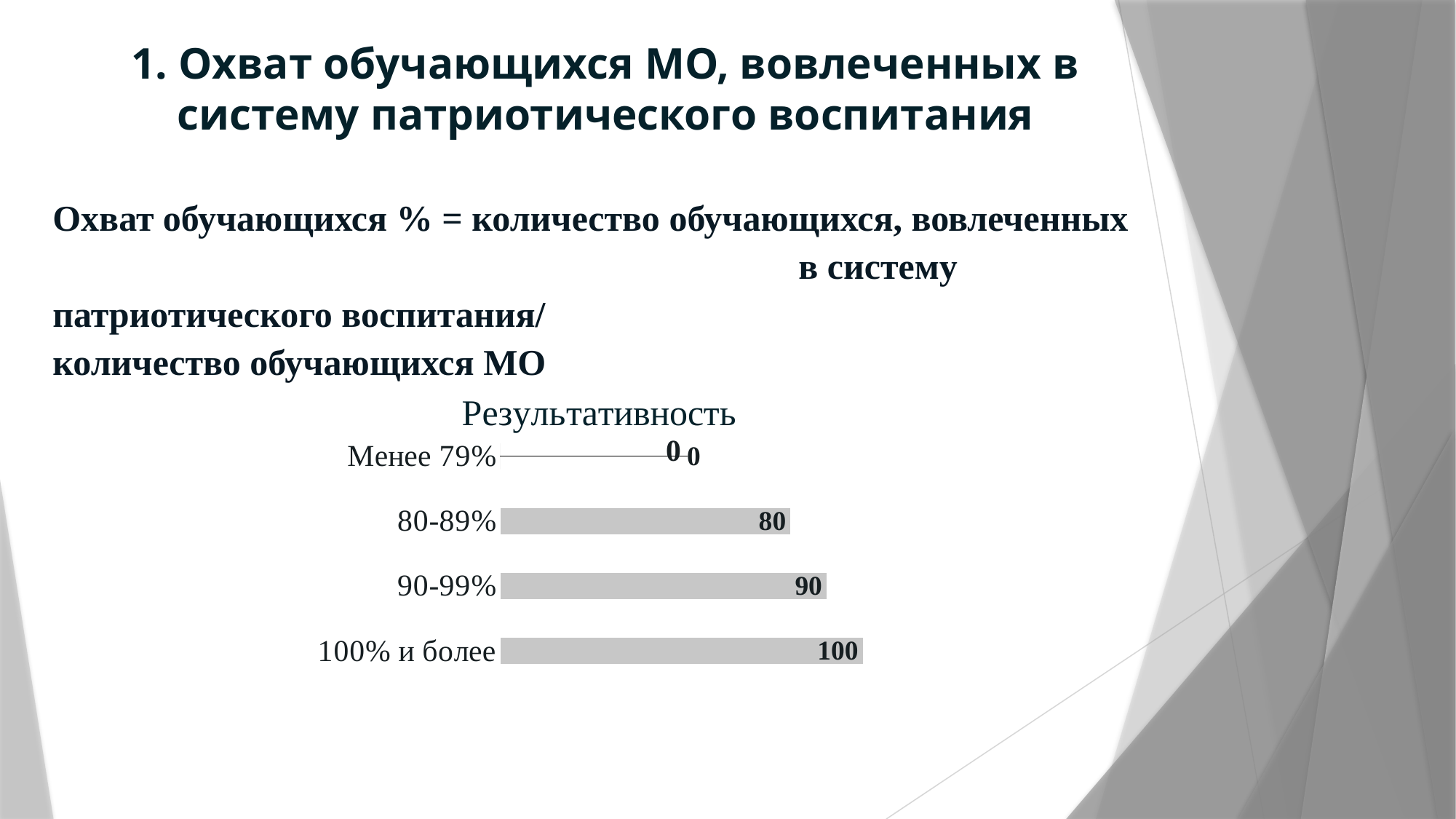
What type of chart is shown on the slide? bar chart What is the difference between the values for "100% и более" and "80-89%"? 20 Which category has the lowest value? Менее 79% Which is larger, the value for "90-99%" or the value for "80-89%"? 90-99% Do the values rise or fall going from the top category to the bottom category? rise What is the value for the category "90-99%"? 90 How many categories does the chart show? 4 What is the title of the chart? Результативность What is the value for the category "Менее 79%"? 0 Which category has the highest value? 100% и более What is the value for the category "100% и более"? 100 What is the value for the category "80-89%"? 80